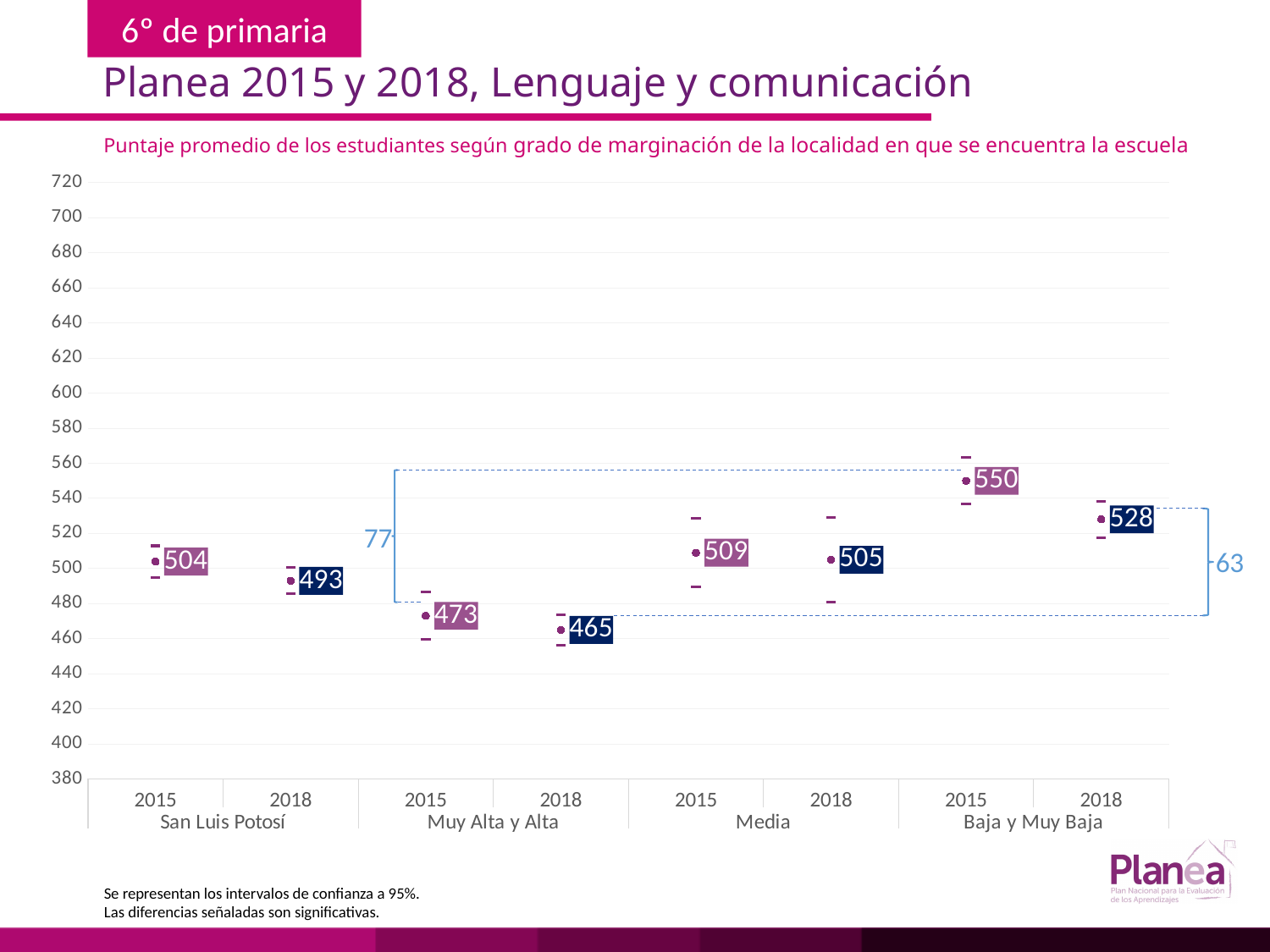
What difference is annotated between the Baja y Muy Baja and Muy Alta y Alta groups for 2018? 63 What is the difference between the 2015 and 2018 scores for San Luis Potosí? 11 What is the average score for the Muy Alta y Alta marginalization group in 2018? 465 What is the average score for the Baja y Muy Baja group in 2015? 550 How many data points are plotted on the chart? 8 Which group and year has the highest average score on the chart? Baja y Muy Baja, 2015 What is the average score for the Media group in 2018? 505 Which group and year has the lowest average score on the chart? Muy Alta y Alta, 2018 Did the average score for the Muy Alta y Alta group rise or fall from 2015 to 2018? Fall Which is larger, the 2015 score for Media or the 2015 score for San Luis Potosí? Media 2015 What is the average score for San Luis Potosí in 2015? 504 What is the difference between the 2015 and 2018 scores for the Baja y Muy Baja group? 22